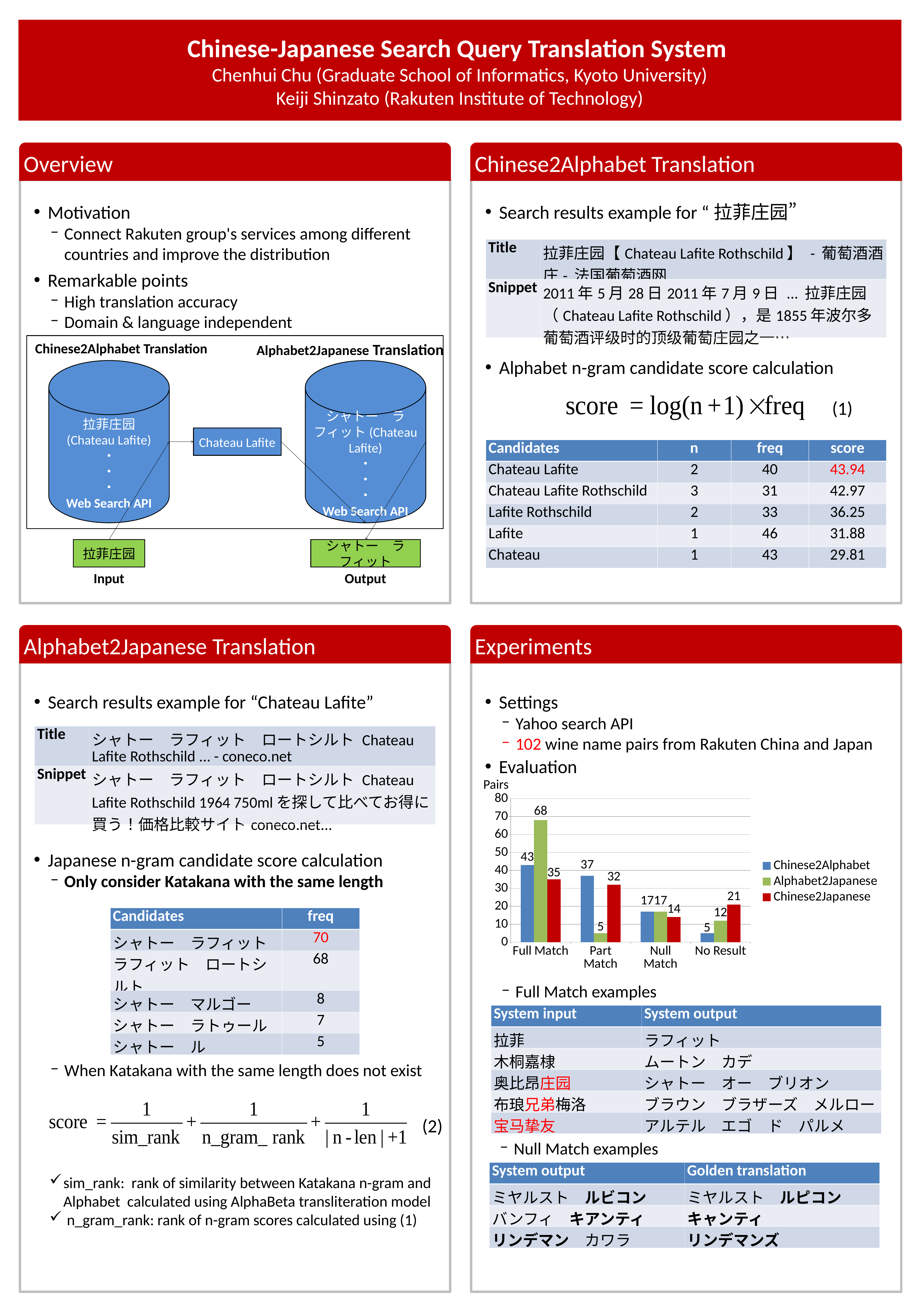
What is the Chinese2Alphabet value for No Result in the Evaluation chart? 5 What is the difference between the Alphabet2Japanese and Chinese2Alphabet values for Full Match in the Evaluation chart? 25 What is the label of the y axis of the Evaluation chart? Pairs What type of chart is shown in the Experiments section? bar chart What is the Chinese2Japanese value for Part Match in the Evaluation chart? 32 How many series does the legend of the Evaluation chart list? 3 Which category has the highest Chinese2Japanese value in the Evaluation chart? Full Match Which category has the lowest Alphabet2Japanese value in the Evaluation chart? Part Match What is the Alphabet2Japanese value for Full Match in the Evaluation chart? 68 What colour are the Chinese2Japanese bars in the Evaluation chart? red For No Result, which series has the larger value in the Evaluation chart: Chinese2Japanese or Alphabet2Japanese? Chinese2Japanese How many categories are shown on the x axis of the Evaluation chart? 4